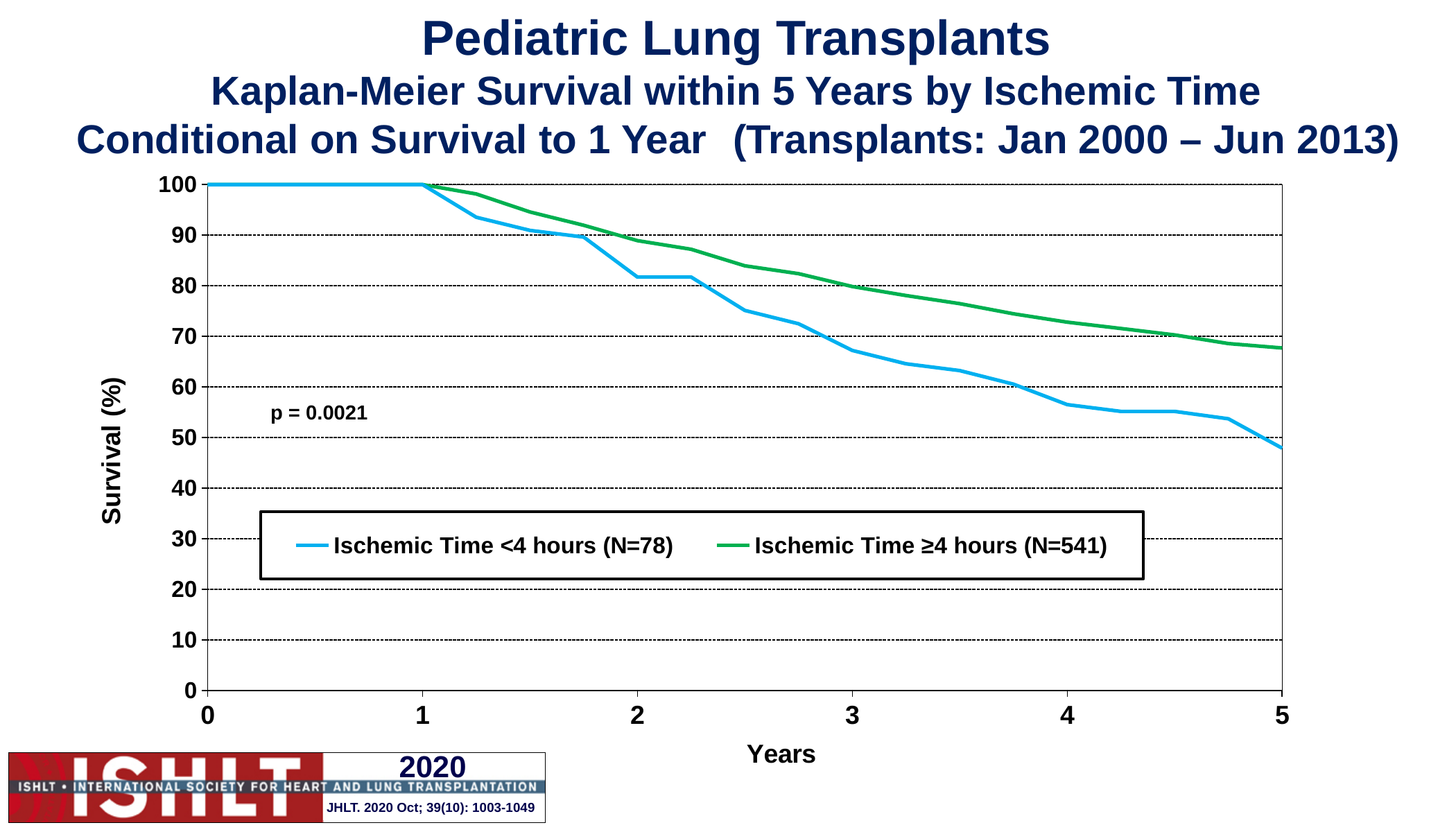
What is the survival (%) for Ischemic Time ≥4 hours at year 0? 100 What p-value is printed on the chart? p = 0.0021 Is the survival for Ischemic Time <4 hours at year 5 greater or less than 60? less Is the survival for Ischemic Time <4 hours at year 3 greater or less than 70? less Do the survival curves rise or fall as years increase from 1 to 5? fall How many series does the legend list? 2 Is the survival for Ischemic Time ≥4 hours at year 5 greater or less than 60? greater What kind of chart is shown on the slide? line chart What is the N for the Ischemic Time ≥4 hours group shown in the legend? 541 At year 5, which series has the higher survival, Ischemic Time <4 hours or Ischemic Time ≥4 hours? Ischemic Time ≥4 hours What is the survival (%) for Ischemic Time <4 hours at year 1? 100